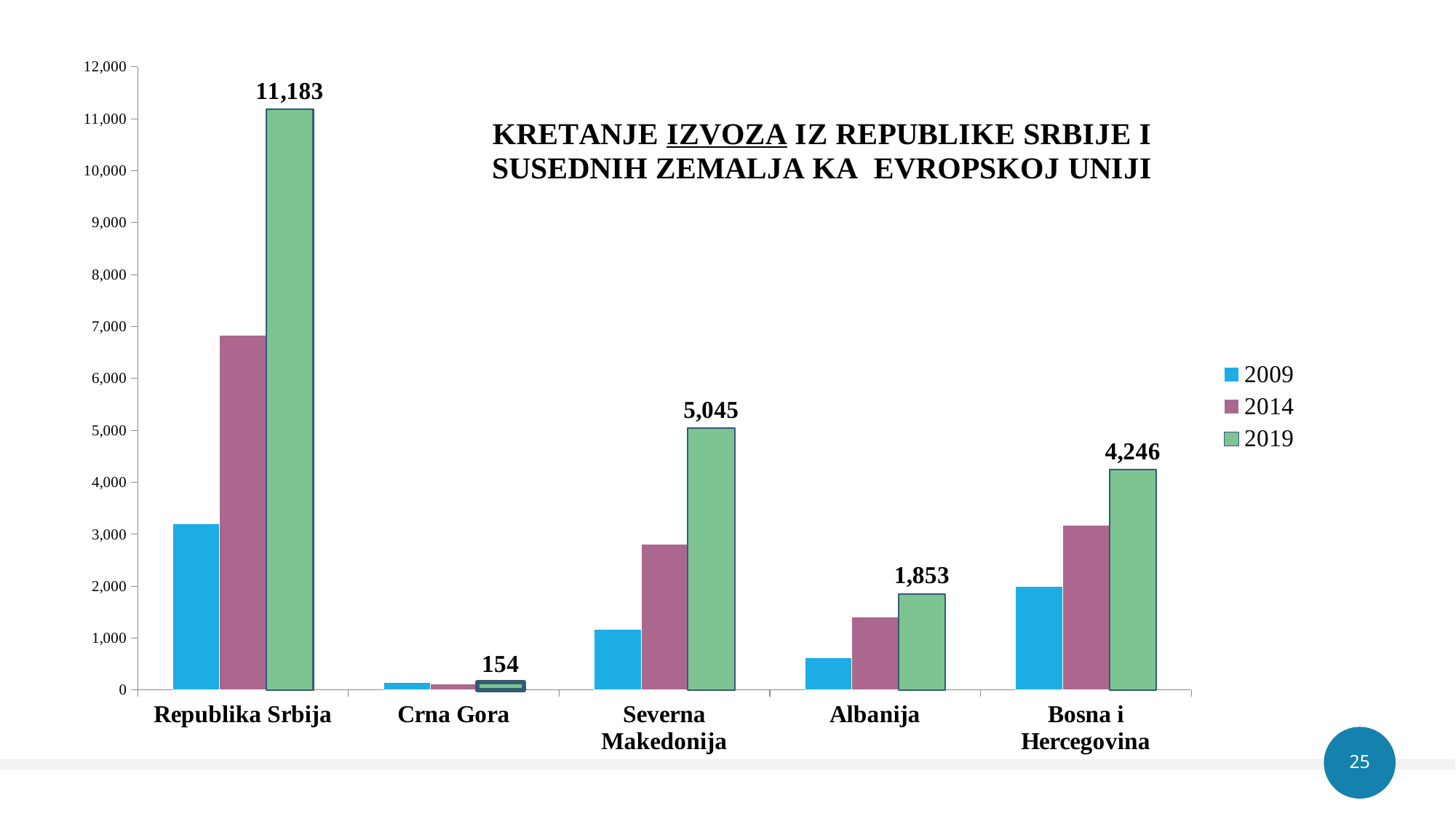
What is the value for Republika Srbija in 2019? 11,183 Which country has the highest value in 2019? Republika Srbija What is the value for Bosna i Hercegovina in 2019? 4,246 Which country has the lowest value in 2019? Crna Gora Do the values for Republika Srbija rise or fall from 2009 to 2019? rise What is the value for Crna Gora in 2019? 154 How many series does the legend list? 3 Is the value for Republika Srbija in 2014 greater or less than 6,000? greater Which is larger in 2019: Severna Makedonija or Bosna i Hercegovina? Severna Makedonija What is the difference between the 2019 values for Republika Srbija and Severna Makedonija? 6,138 How many countries are shown on the x axis? 5 What is the value for Severna Makedonija in 2019? 5,045